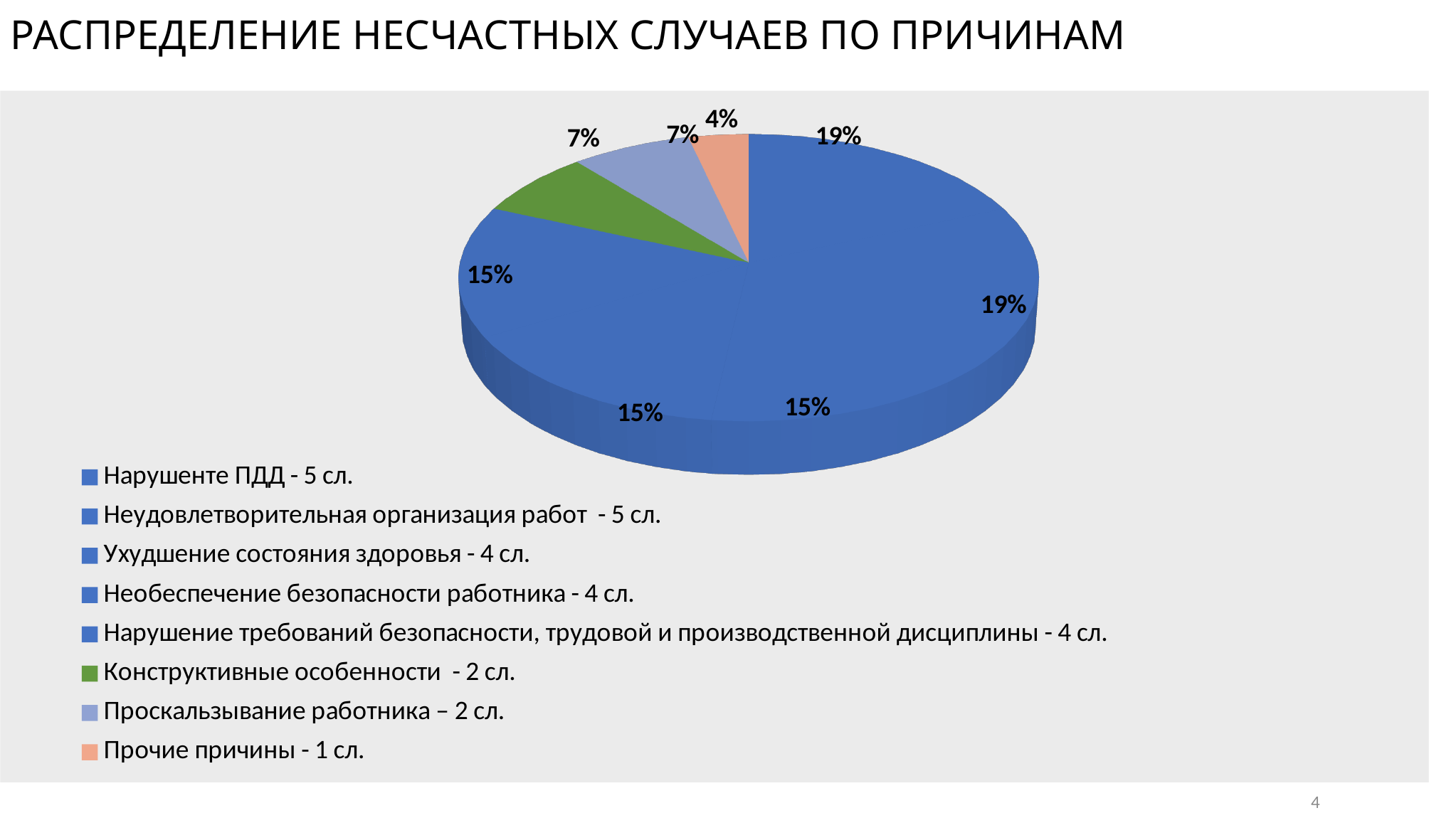
By how many percentage points does the 'Конструктивные особенности' slice exceed the 'Прочие причины' slice? 3 percentage points What kind of chart is shown on the slide? Pie chart According to the legend, how many cases are attributed to 'Нарушение ПДД'? 5 сл. What is the title of the chart on the slide? РАСПРЕДЕЛЕНИЕ НЕСЧАСТНЫХ СЛУЧАЕВ ПО ПРИЧИНАМ How many entries does the legend list? 8 According to the legend, how many cases are attributed to 'Ухудшение состояния здоровья'? 4 сл. What share of the pie does 'Конструктивные особенности' take? 7% What share of the pie does 'Прочие причины' take? 4% Which slice is larger: 'Конструктивные особенности' or 'Прочие причины'? Конструктивные особенности Which category has the smallest slice of the pie? Прочие причины How many slices does the pie chart have? 8 What share of the pie does 'Проскальзывание работника' take? 7%